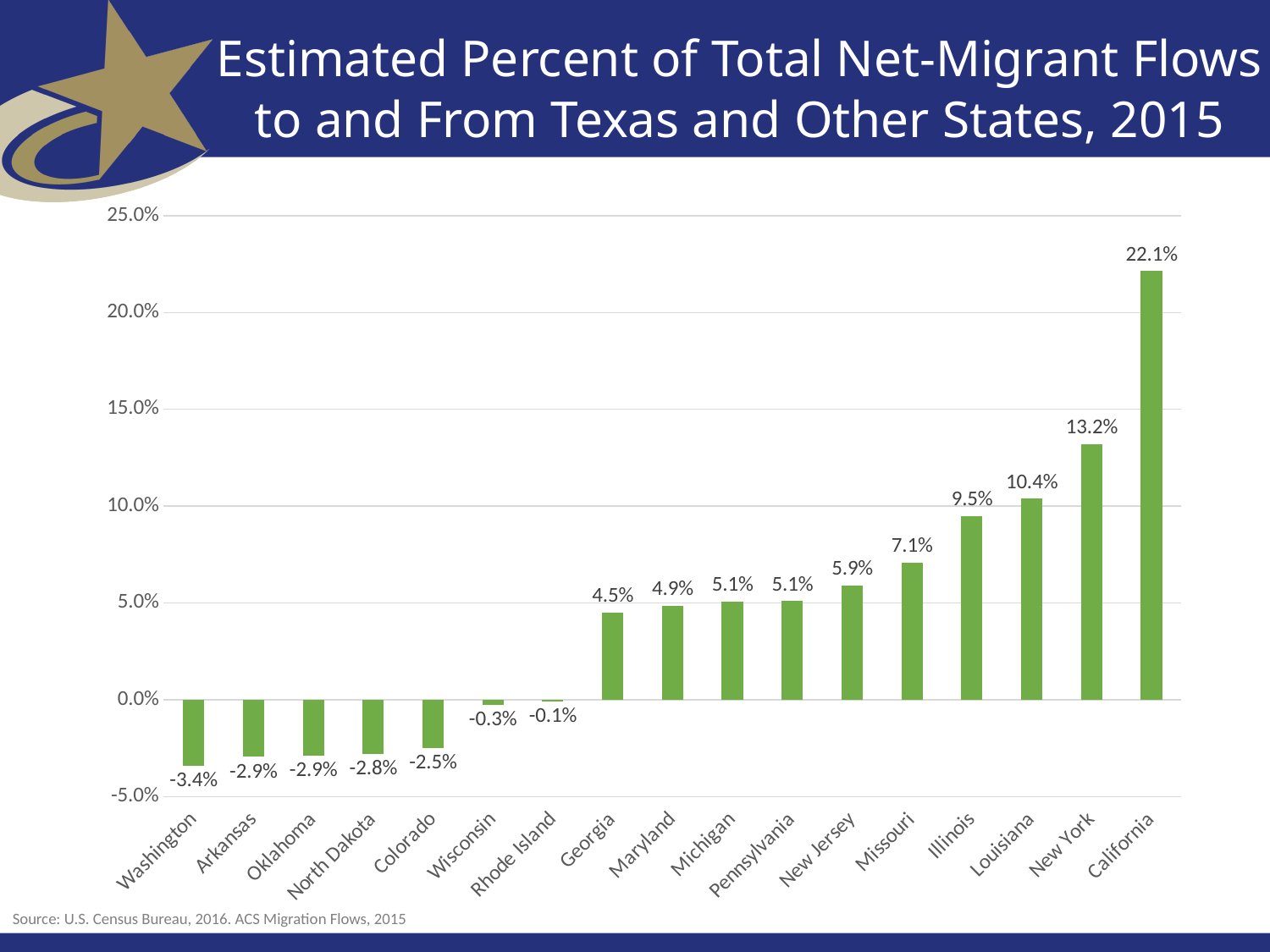
What is the title of the chart? Estimated Percent of Total Net-Migrant Flows to and From Texas and Other States, 2015 What is the value for Washington? -3.4% Which state has the highest value? California What is the difference between the values for California and New York? 8.9% Do the values rise or fall from left to right along the x axis? Rise Which state has the lowest value? Washington What is the value for California? 22.1% What is the value for Missouri? 7.1% Is the value for New York greater or less than 10.0%? greater How many states are shown on the chart? 17 What kind of chart is this? Bar chart Which is larger, the value for Illinois or the value for Louisiana? Louisiana